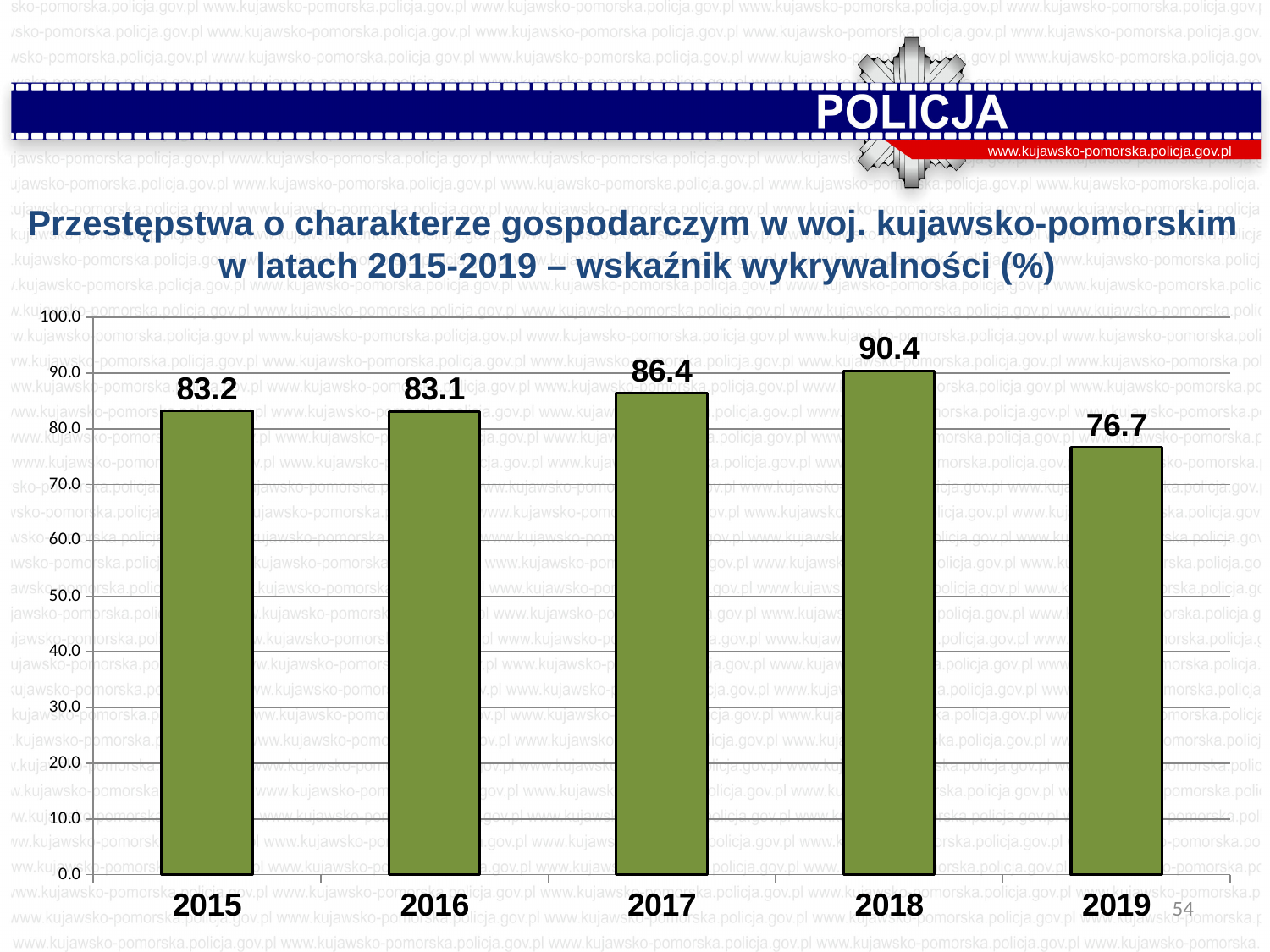
What is the value shown for 2019? 76.7 What is the detection rate value shown for 2018? 90.4 Which year has the highest value? 2018 What kind of chart is shown on the slide? bar chart How many years are shown on the x axis? 5 What is the difference between the values for 2018 and 2019? 13.7 Which year has the lowest value? 2019 What is the difference between the values for 2017 and 2016? 3.3 Is the value for 2018 greater or less than 90.0? greater Do the values rise or fall from 2018 to 2019? fall What is the value shown for 2015? 83.2 Which is larger, the value for 2017 or the value for 2019? 2017